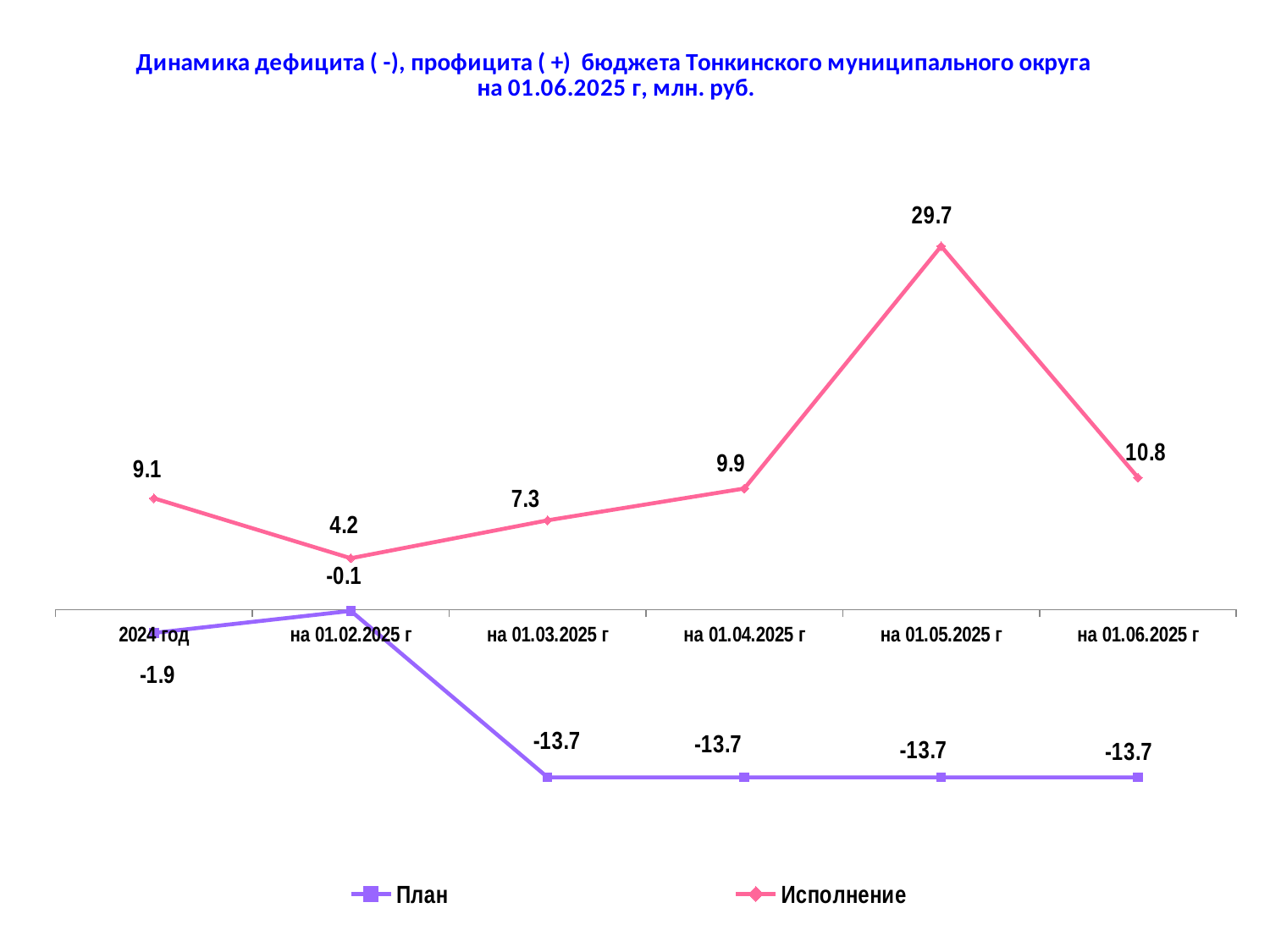
What is the План value for 2024 год? -1.9 How many series does the legend list? 2 Does the План series rise or fall from на 01.02.2025 г to на 01.03.2025 г? fall What is the План value for на 01.02.2025 г? -0.1 What is the Исполнение value for на 01.06.2025 г? 10.8 What is the difference between the Исполнение values for на 01.05.2025 г and на 01.06.2025 г? 18.9 What kind of chart is shown on the slide? line chart Which is larger: the Исполнение value for на 01.03.2025 г or for на 01.04.2025 г? на 01.04.2025 г At which date is the Исполнение series lowest? на 01.02.2025 г At which date does the Исполнение series reach its highest value? на 01.05.2025 г What is the Исполнение value for на 01.05.2025 г? 29.7 How many dates are shown on the x axis? 6